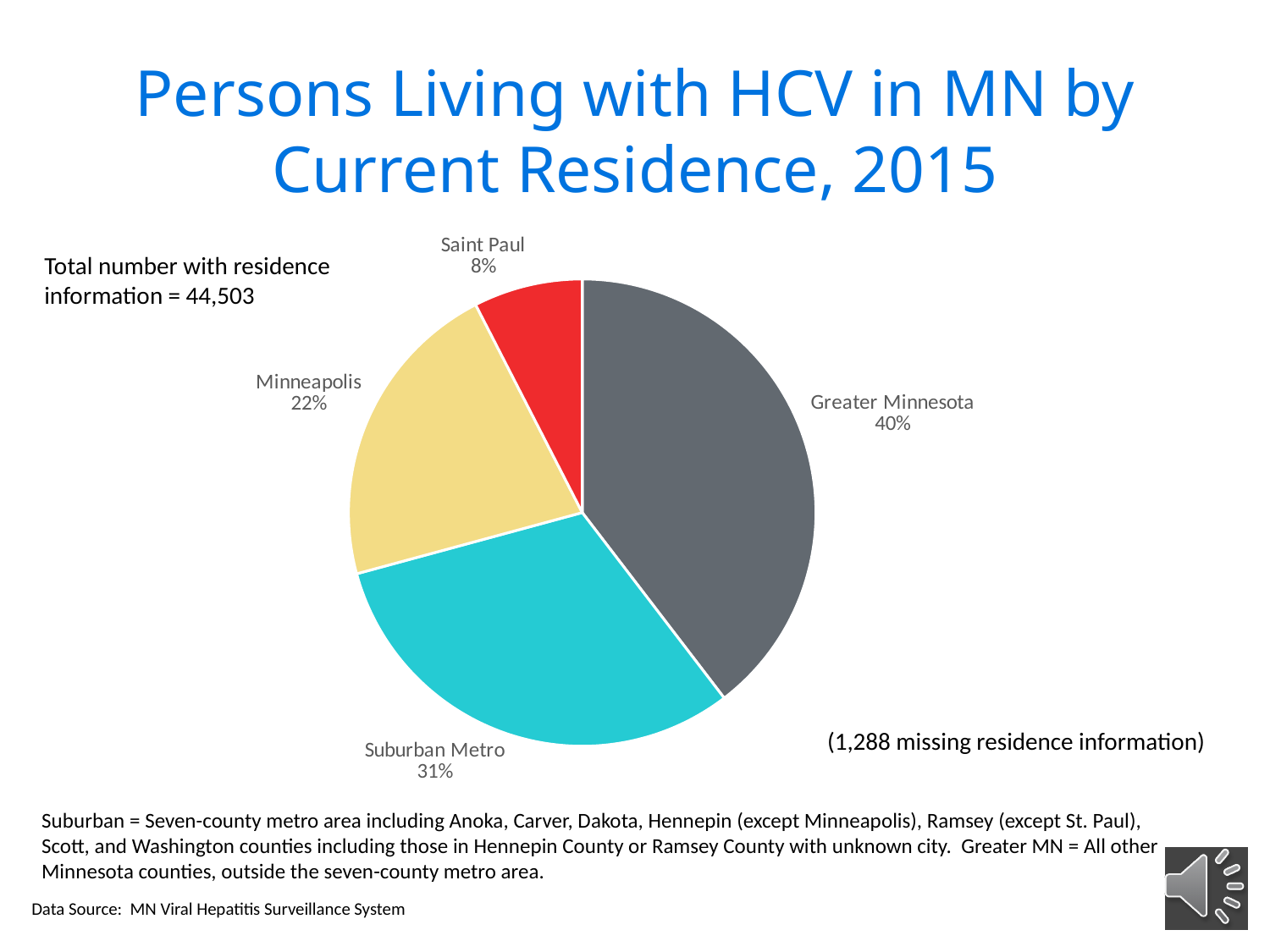
What type of chart is shown on the slide? Pie chart What is the difference in percentage points between Greater Minnesota and Minneapolis? 18 How many slices does the pie chart have? 4 Which is larger, the share for Suburban Metro or the share for Minneapolis? Suburban Metro What is the total number of persons with residence information stated on the slide? 44,503 What is the value shown for Saint Paul? 8% What is the value shown for Minneapolis? 22% Which residence category has the smallest share of the pie? Saint Paul Which residence category has the largest share of the pie? Greater Minnesota What share of persons living with HCV in MN reside in Greater Minnesota? 40% What colour is the Saint Paul slice? Red What percentage of the pie is Suburban Metro? 31%